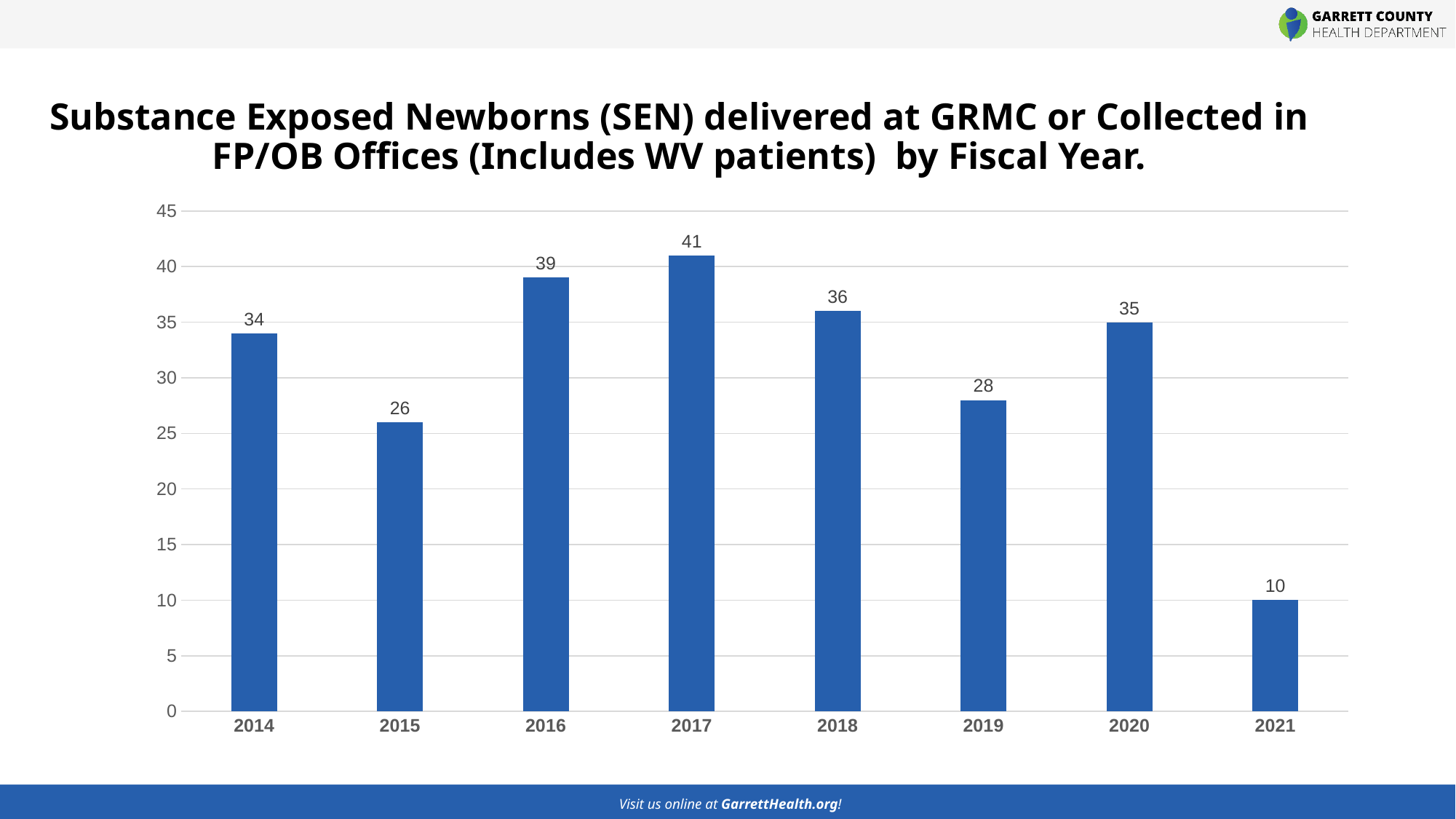
Which fiscal year has the highest value? 2017 What is the value for 2015? 26 What kind of chart is shown on the slide? bar chart Is the value for 2019 greater or less than 30? less Which is larger, the value for 2018 or the value for 2020? 2018 How many fiscal years are shown on the x axis? 8 What is the value for 2017? 41 What is the difference between the values for 2017 and 2021? 31 What is the difference between the values for 2016 and 2015? 13 Do the values rise or fall from 2020 to 2021? fall Which fiscal year has the lowest value? 2021 What is the value for 2021? 10